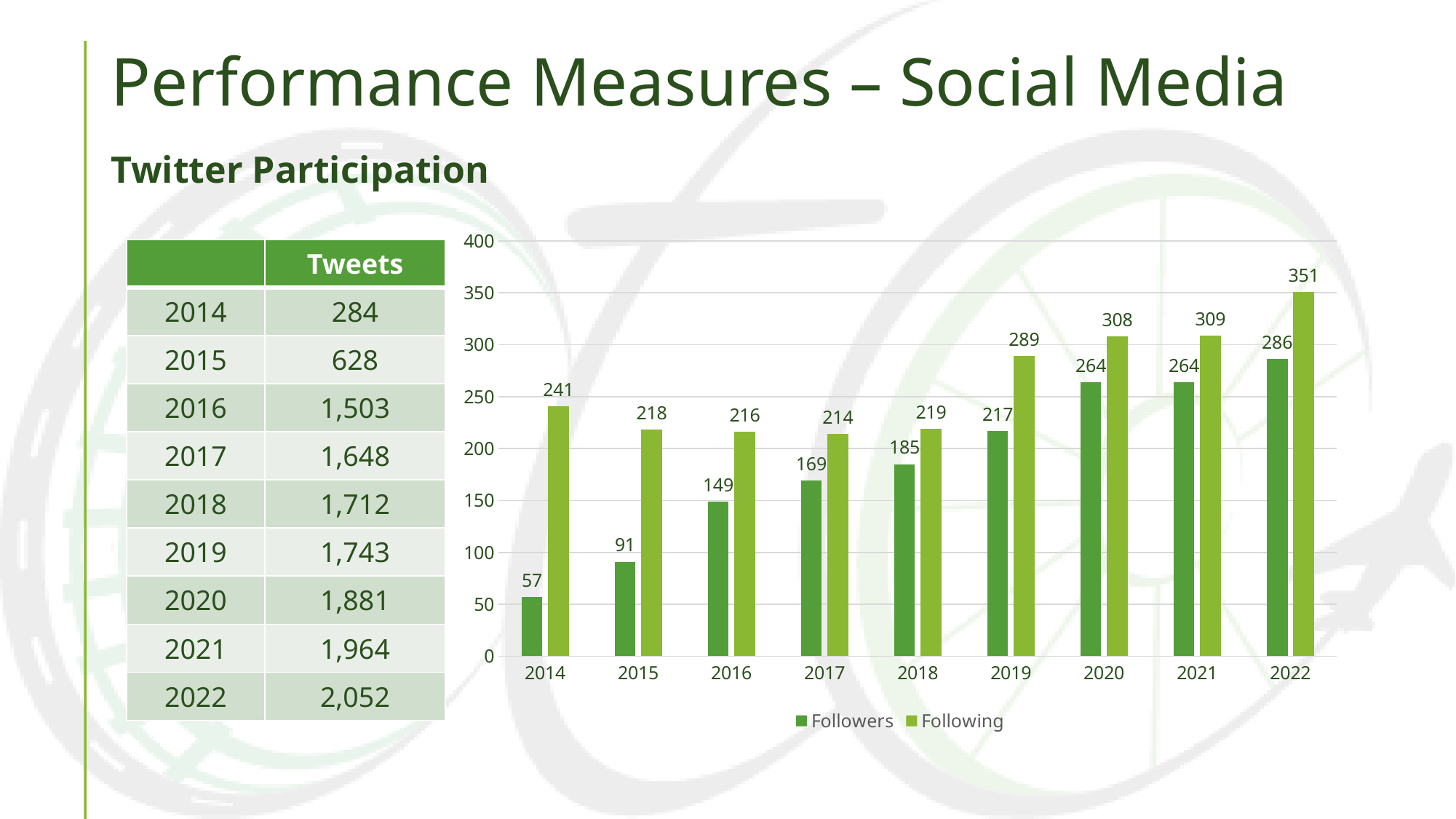
Which is larger in 2016, Followers or Following? Following Which year has the highest Following value? 2022 What is the difference between Following and Followers in 2019? 72 What is the Followers value for 2018? 185 How many years are shown on the x axis of the chart? 9 What kind of chart is shown on the slide? Bar chart What is the Followers value for 2014? 57 What is the Following value for 2022? 351 What are the two series named in the chart legend? Followers and Following Do the Followers values generally rise or fall from 2014 to 2022? Rise Which year has the lowest Followers value? 2014 How many series does the chart legend list? 2